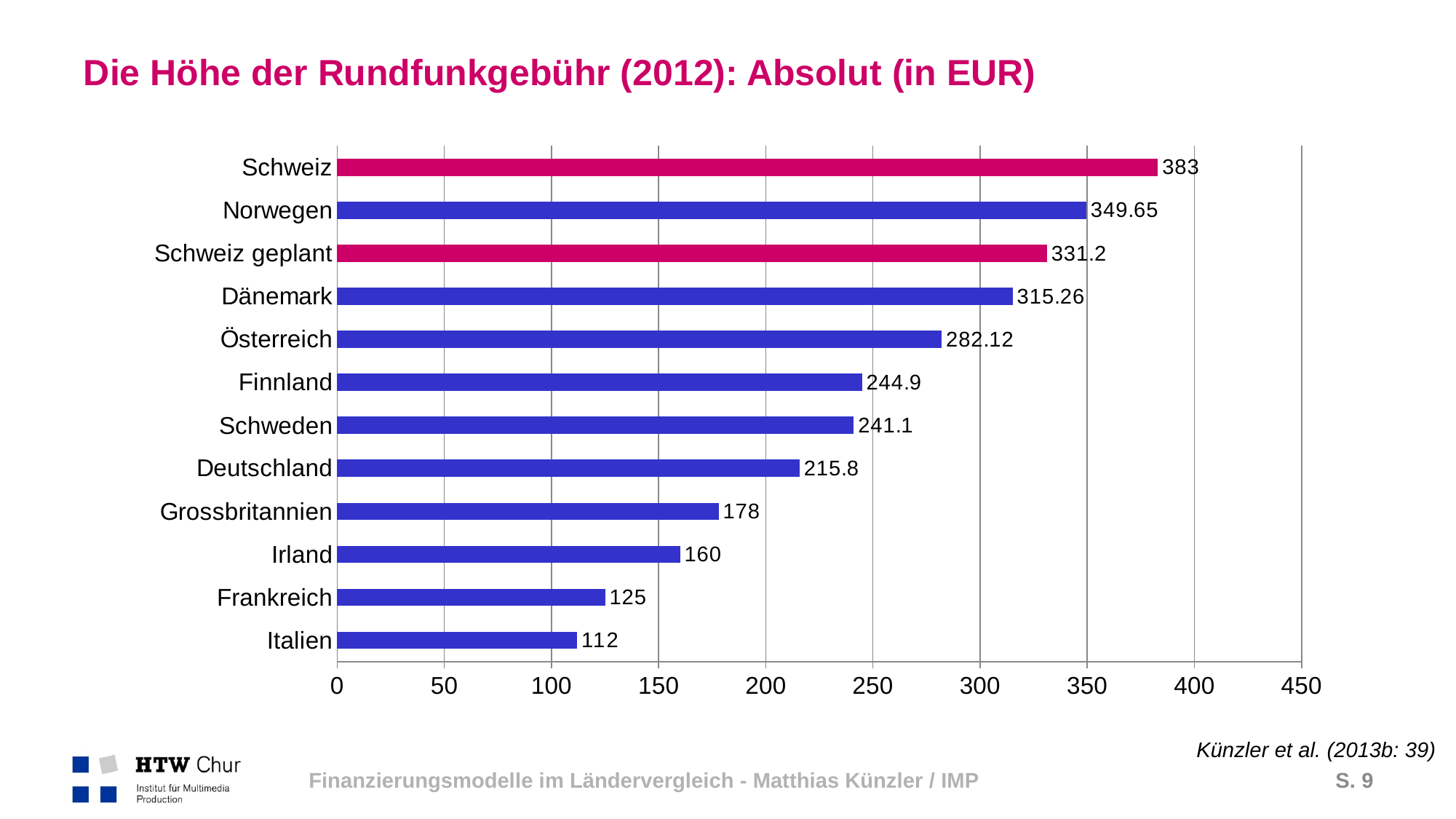
Which category has the lowest value? Italien What is the difference between the values for Schweiz and Schweiz geplant? 51.8 How many categories are shown in the chart? 12 What is the difference between the values for Grossbritannien and Irland? 18 Which category has the highest value? Schweiz What is the value for Deutschland? 215.8 Is the value for Frankreich greater or less than 150? less What kind of chart is shown on the slide? bar chart Which is larger, the value for Dänemark or the value for Österreich? Dänemark What is the value for Norwegen? 349.65 Which categories are shown with a magenta bar instead of a blue one? Schweiz and Schweiz geplant What is the value for Schweiz geplant? 331.2